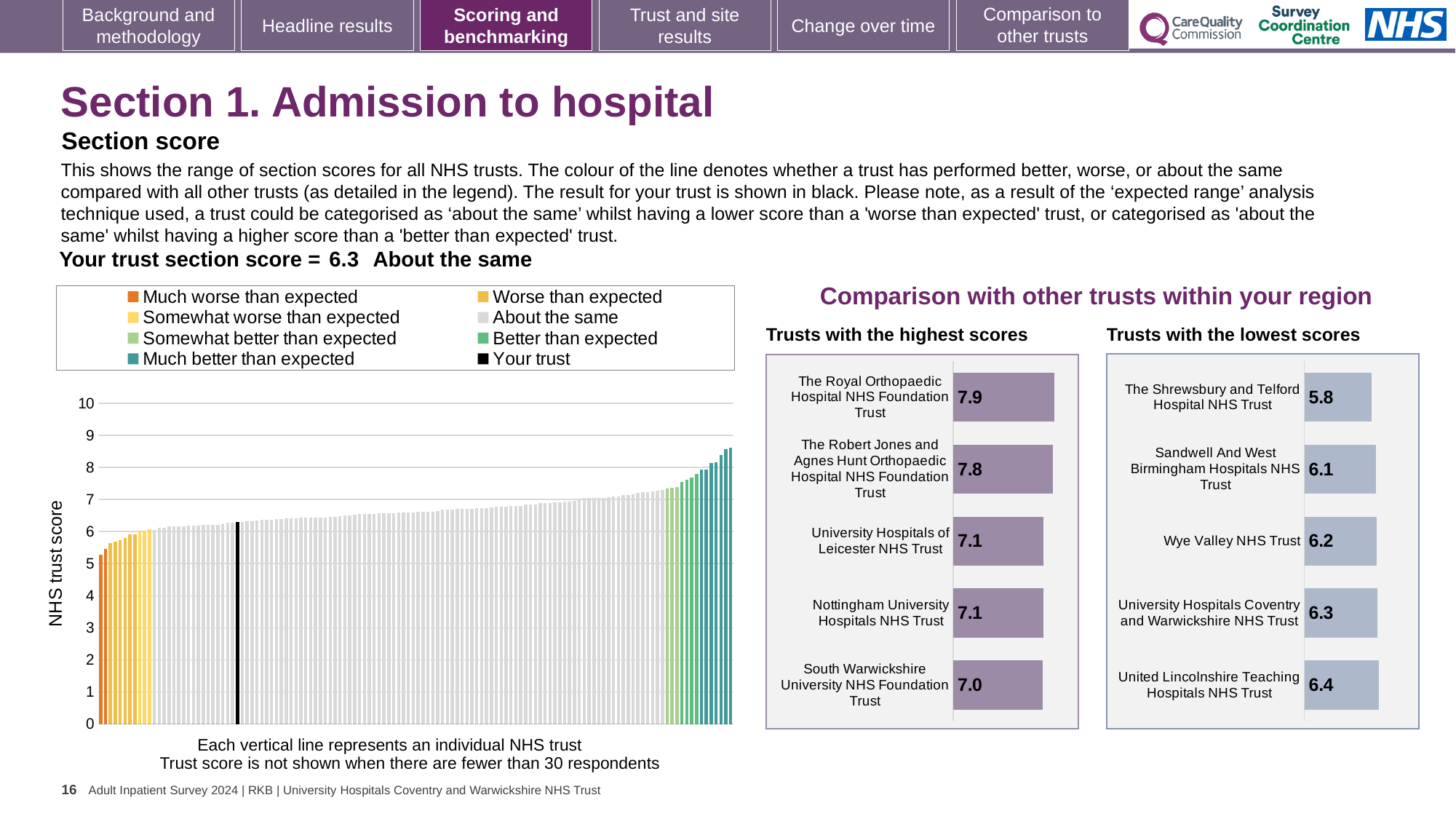
In the 'Trusts with the lowest scores' chart, what is the score for The Shrewsbury and Telford Hospital NHS Trust? 5.8 In the 'Trusts with the highest scores' chart, which trust has the highest score? The Royal Orthopaedic Hospital NHS Foundation Trust In the 'Trusts with the highest scores' chart, what is the difference between the scores of The Royal Orthopaedic Hospital NHS Foundation Trust and South Warwickshire University NHS Foundation Trust? 0.9 How many trusts are shown in the 'Trusts with the highest scores' chart? 5 In the 'Trusts with the lowest scores' chart, what is the difference between the scores of United Lincolnshire Teaching Hospitals NHS Trust and The Shrewsbury and Telford Hospital NHS Trust? 0.6 In the 'Trusts with the lowest scores' chart, which trust has the lowest score? The Shrewsbury and Telford Hospital NHS Trust How many entries does the legend of the large 'NHS trust score' chart list? 8 In the 'Trusts with the lowest scores' chart, which has the higher score: Sandwell And West Birmingham Hospitals NHS Trust or United Lincolnshire Teaching Hospitals NHS Trust? United Lincolnshire Teaching Hospitals NHS Trust In the 'Trusts with the highest scores' chart, what is the score for The Royal Orthopaedic Hospital NHS Foundation Trust? 7.9 In the 'Trusts with the highest scores' chart, what is the score for South Warwickshire University NHS Foundation Trust? 7.0 What kind of chart is the large 'NHS trust score' chart on the left of the slide? Bar chart In the 'Trusts with the lowest scores' chart, what is the score for Wye Valley NHS Trust? 6.2